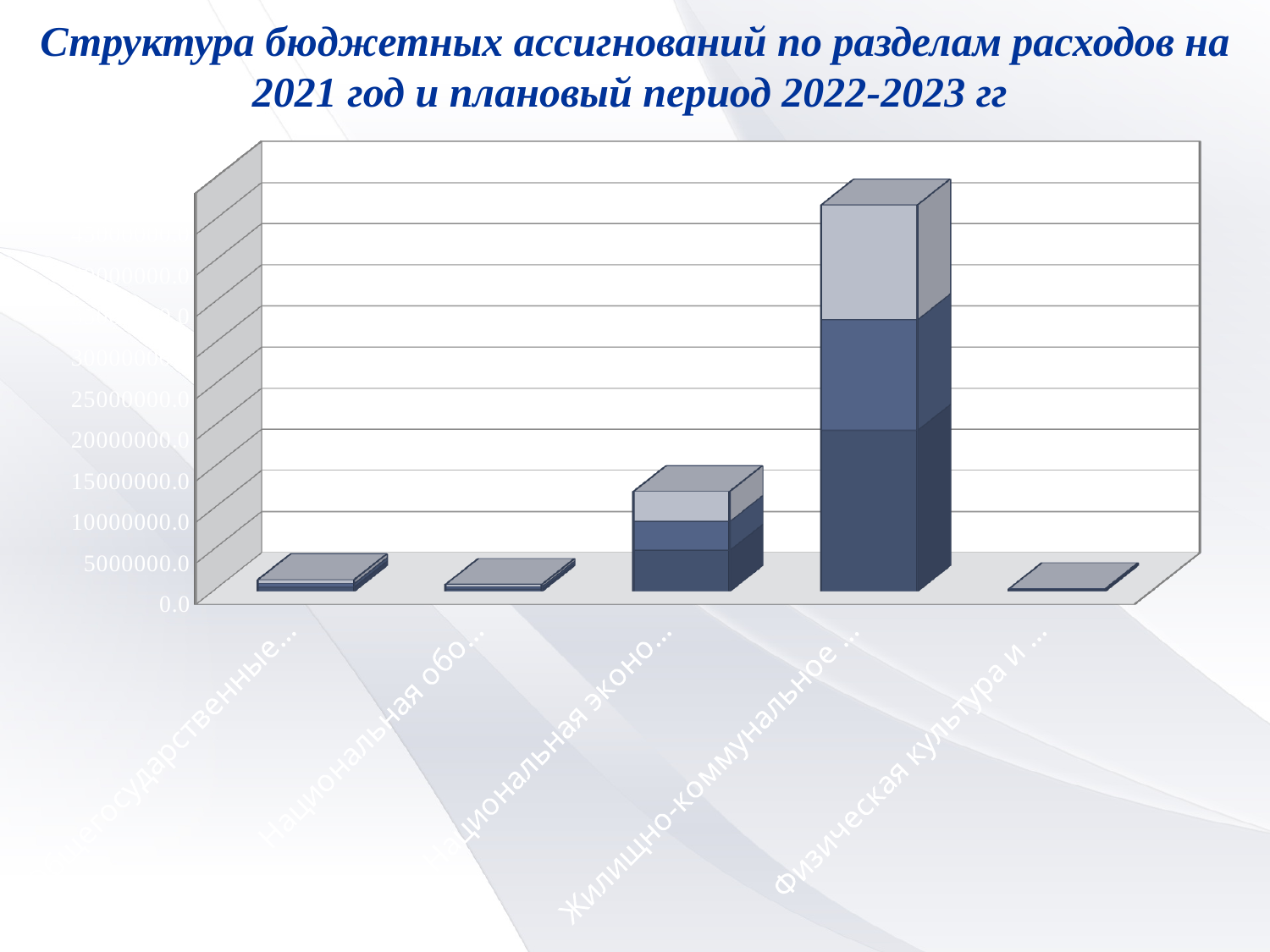
Is the total value for Национальная эконо... greater or less than 5000000.0? greater Is the total value for Физическая культура и ... greater or less than 5000000.0? less Is the total value for Общегосударственные... greater or less than 5000000.0? less What kind of chart is shown on the slide? bar chart What is the title of the slide containing the chart? Структура бюджетных ассигнований по разделам расходов на 2021 год и плановый период 2022-2023 гг Which bar is taller: Национальная эконо... or Общегосударственные...? Национальная эконо... Which bar is taller: Жилищно-коммунальное ... or Национальная эконо...? Жилищно-коммунальное ... How many categories are shown along the x axis of the chart? 5 Which category has the tallest bar in the chart? Жилищно-коммунальное ... How many stacked segments make up the bar for Жилищно-коммунальное ...? 3